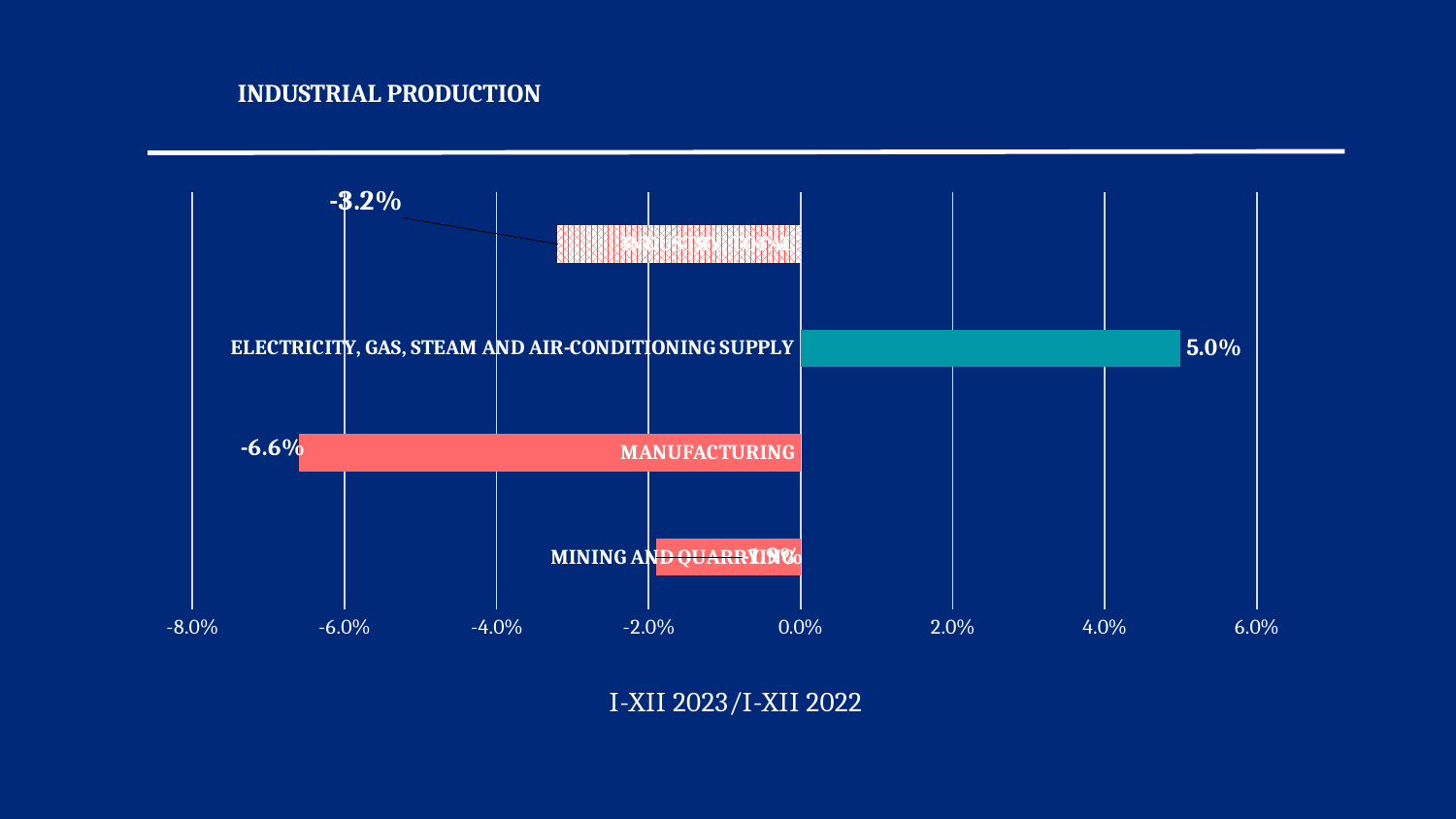
What is the difference between the values for Electricity, gas, steam and air-conditioning supply and Manufacturing? 11.6 percentage points What kind of chart is shown on the slide? Bar chart How many bars are plotted in the chart? 4 Is the value for Manufacturing greater or less than -6.0%? less Is the value for Mining and quarrying greater or less than -4.0%? greater Is the value for Electricity, gas, steam and air-conditioning supply greater or less than 4.0%? greater What is the value for Electricity, gas, steam and air-conditioning supply? 5.0% Which category has the lowest value? Manufacturing Which is larger, the value for Manufacturing or the value for Mining and quarrying? Mining and quarrying Which category has the highest value? Electricity, gas, steam and air-conditioning supply What is the title of the chart? I-XII 2023/I-XII 2022 What is the value for Manufacturing? -6.6%